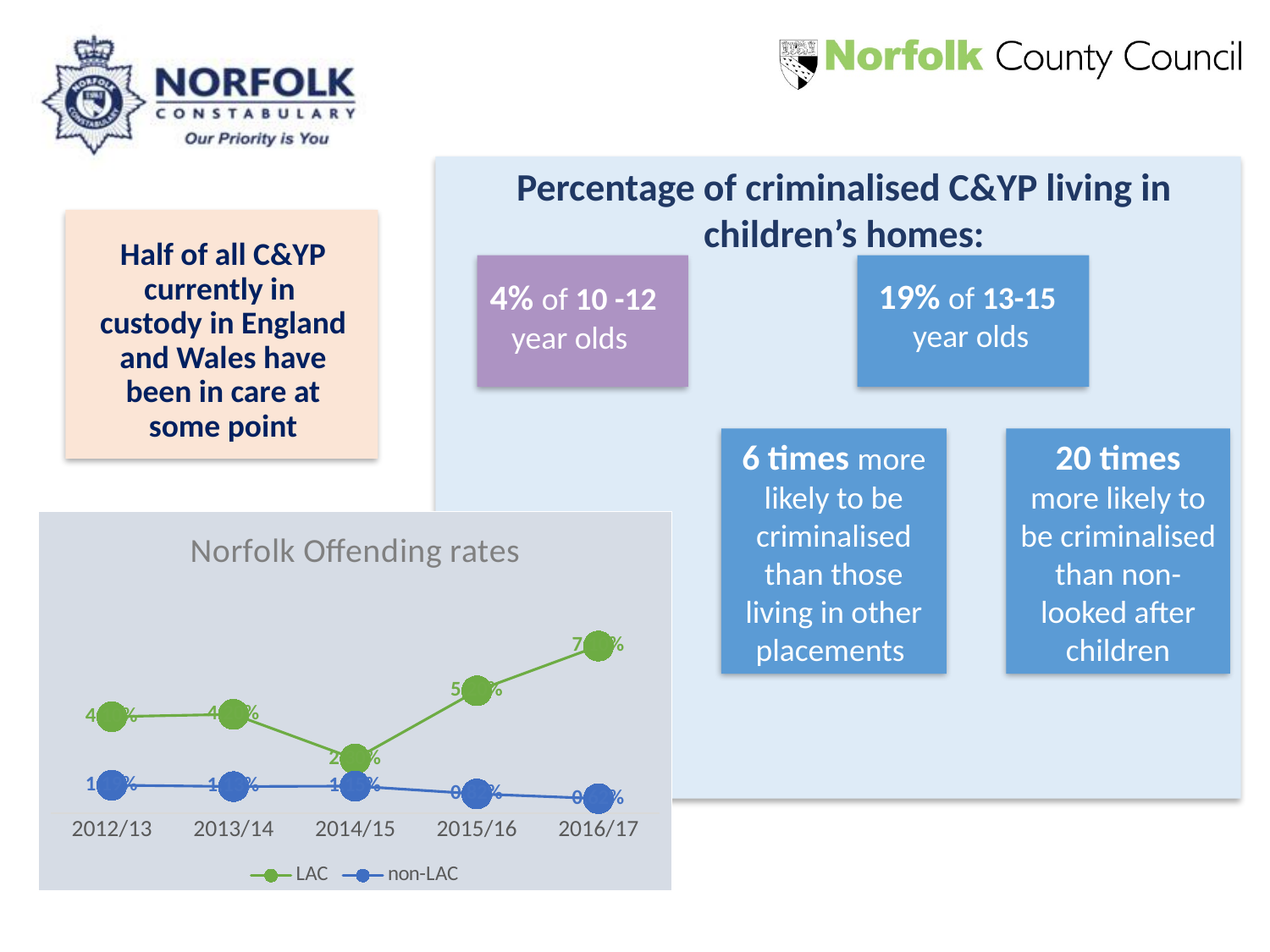
In which year is the LAC offending rate lowest in the Norfolk Offending rates chart? 2014/15 What kind of chart is the Norfolk Offending rates chart? line chart What colour is the LAC line in the Norfolk Offending rates chart? green What are the two series named in the legend of the Norfolk Offending rates chart? LAC and non-LAC In the Norfolk Offending rates chart, does the LAC line rise or fall from 2014/15 to 2016/17? rise What is the first year shown on the x axis of the Norfolk Offending rates chart? 2012/13 How many years are shown on the x axis of the Norfolk Offending rates chart? 5 In which year is the LAC offending rate highest in the Norfolk Offending rates chart? 2016/17 In the Norfolk Offending rates chart, which series has the lower value in 2012/13, LAC or non-LAC? non-LAC In the Norfolk Offending rates chart, does the LAC line rise or fall from 2013/14 to 2014/15? fall How many series does the legend of the Norfolk Offending rates chart list? 2 In the Norfolk Offending rates chart, which series has the higher value in 2016/17, LAC or non-LAC? LAC